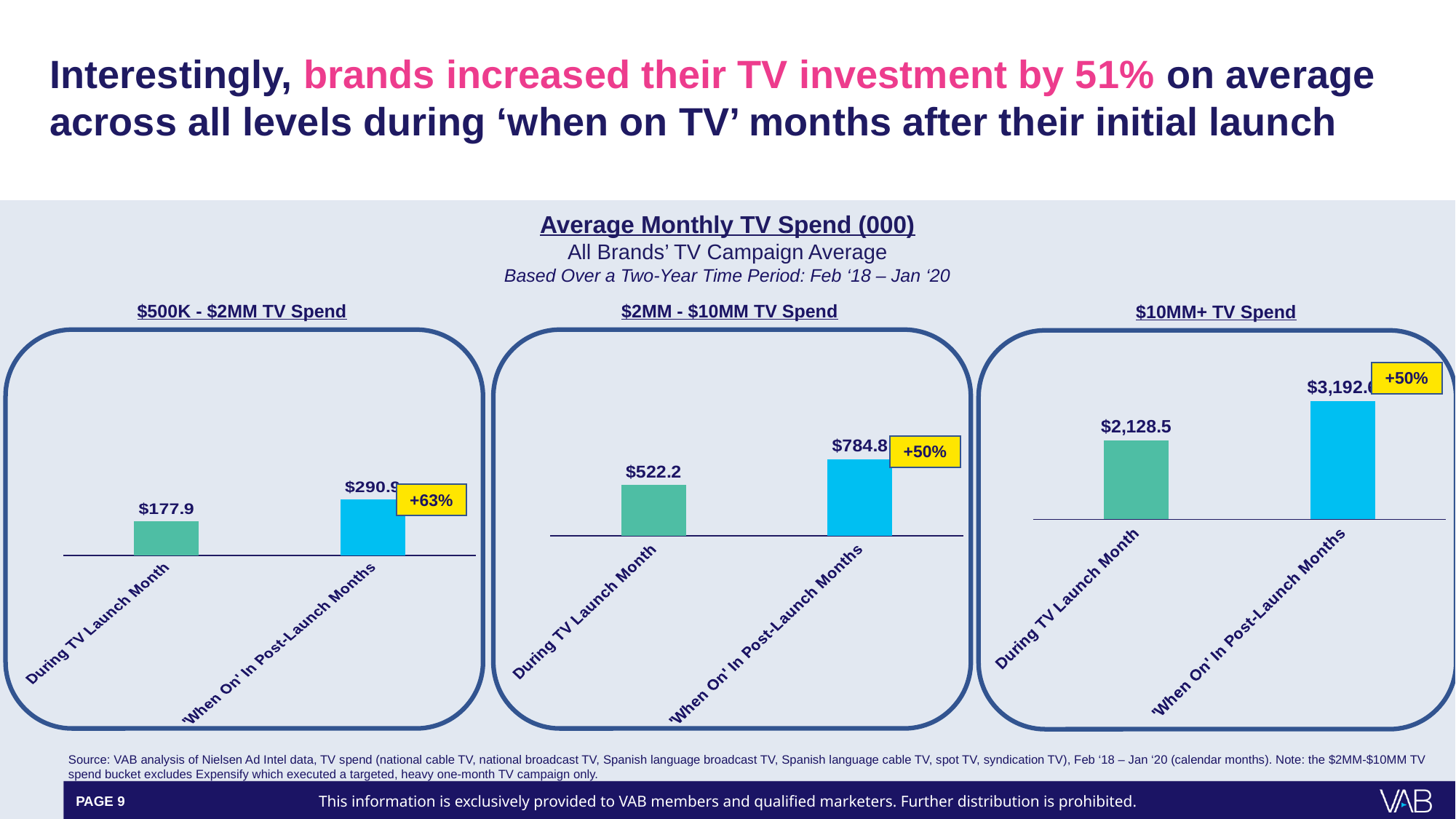
What type of chart is the $2MM - $10MM TV Spend chart? Bar chart In the $2MM - $10MM TV Spend chart, what is the difference between the post-launch months value and the launch month value? $262.6 In the $500K - $2MM TV Spend chart, which category has the lowest value? During TV Launch Month What percentage increase is shown in the callout on the $10MM+ TV Spend chart? +50% In the $2MM - $10MM TV Spend chart, what is the value for 'During TV Launch Month'? $522.2 In the $500K - $2MM TV Spend chart, what is the average monthly TV spend during the TV launch month? $177.9 In the $2MM - $10MM TV Spend chart, what is the value for 'When On' In Post-Launch Months? $784.8 How many categories are plotted in the $10MM+ TV Spend chart? 2 In the $10MM+ TV Spend chart, what is the value for 'During TV Launch Month'? $2,128.5 In the $2MM - $10MM TV Spend chart, do the values rise or fall from the launch month to the post-launch months? Rise What percentage increase is shown in the callout on the $500K - $2MM TV Spend chart? +63% In the $10MM+ TV Spend chart, which category has the higher value: 'During TV Launch Month' or 'When On' In Post-Launch Months? 'When On' In Post-Launch Months